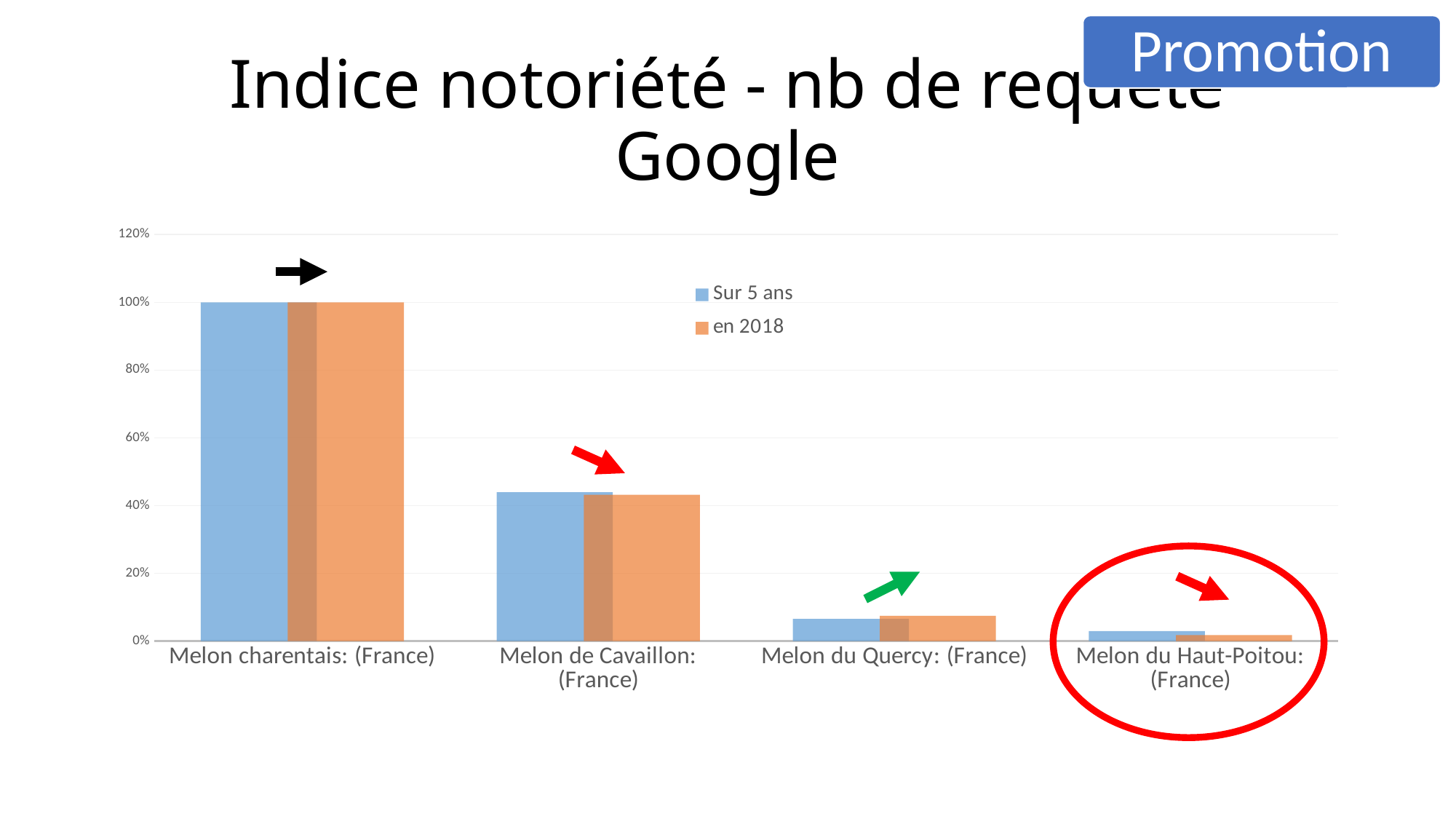
What is the value for Melon charentais: (France) in the 'en 2018' series? 100% What is the value for Melon charentais: (France) in the 'Sur 5 ans' series? 100% Is the 'Sur 5 ans' value for Melon de Cavaillon: (France) greater or less than 40%? greater Which category has the lowest value in the 'en 2018' series? Melon du Haut-Poitou: (France) Do the 'Sur 5 ans' values rise or fall from left to right along the x axis? fall Is the 'en 2018' value for Melon du Quercy: (France) greater or less than 20%? less Which category has the highest value in the 'Sur 5 ans' series? Melon charentais: (France) What kind of chart is shown on the slide? bar chart Which series is shown in orange in the legend? en 2018 How many categories are shown on the x axis? 4 How many series does the legend list? 2 In the 'Sur 5 ans' series, which is larger: Melon de Cavaillon: (France) or Melon du Quercy: (France)? Melon de Cavaillon: (France)